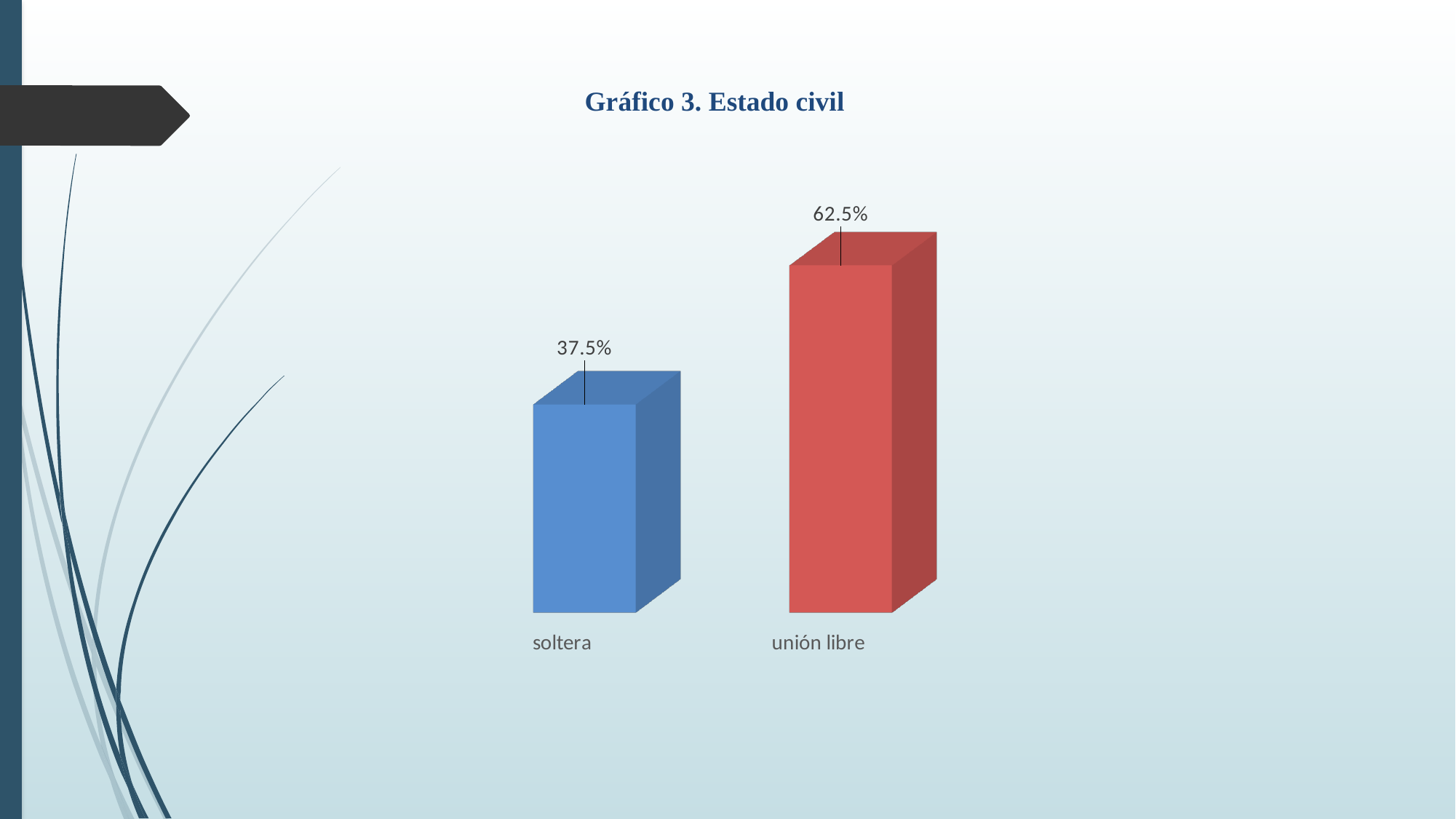
What is the difference between the values for unión libre and soltera? 25% What is the value for unión libre? 62.5% How many categories are shown in the chart? 2 What kind of chart is shown on the slide? bar chart What is the value for soltera? 37.5% Which category has the highest value? unión libre Which category has the lowest value? soltera What is the total of the two values shown in the chart? 100% Which is larger, the value for soltera or the value for unión libre? unión libre What is the title of the chart? Gráfico 3. Estado civil What colour is the bar for unión libre? red